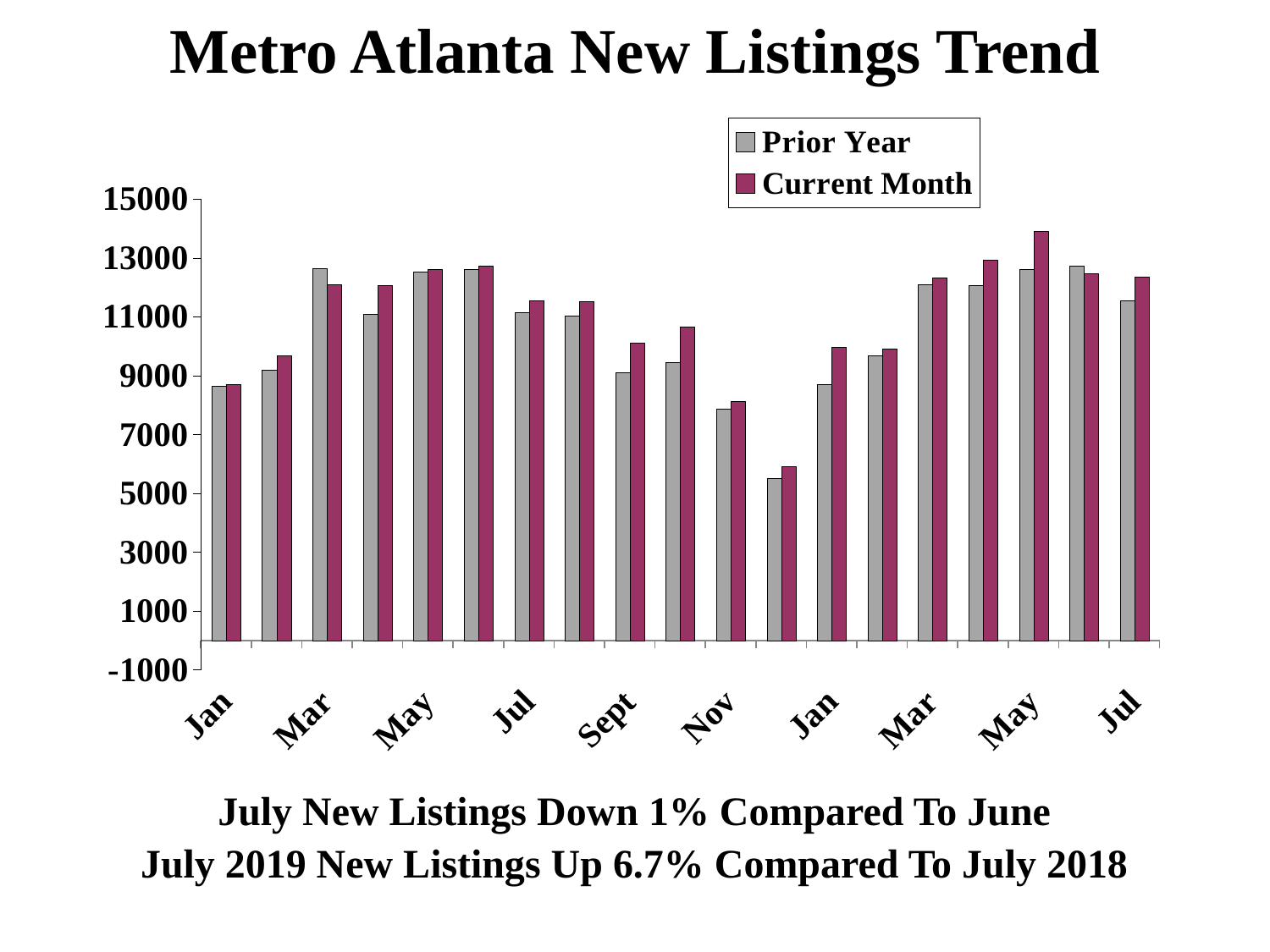
What kind of chart is shown on the slide? Bar chart Is the Current Month value for the first Jan greater or less than 9000? less For Sept, which is larger: the Prior Year value or the Current Month value? Current Month Is the Current Month value for the second May greater or less than 13000? greater For the first Mar, which is larger: the Prior Year value or the Current Month value? Prior Year For the second Jul, which is larger: the Prior Year value or the Current Month value? Current Month What is the title of the chart? Metro Atlanta New Listings Trend What are the two series named in the legend? Prior Year and Current Month How many series does the legend list? 2 Is the Current Month value for Sept greater or less than 9000? greater Which month has the highest Current Month value? May (the second May)